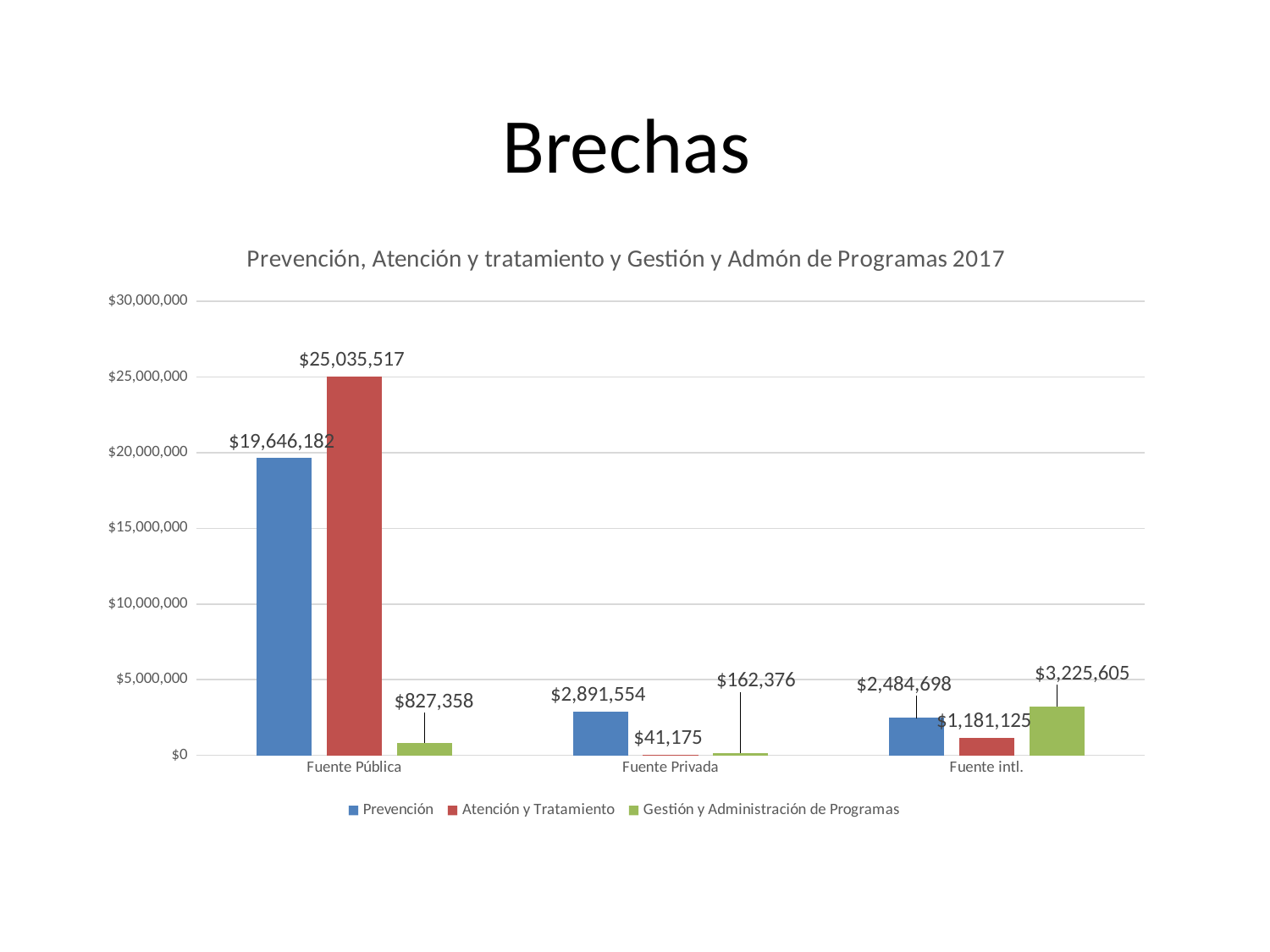
Which category has the highest value for Prevención? Fuente Pública What type of chart is shown on the slide? Bar chart What is the value for Atención y Tratamiento in Fuente Pública? $25,035,517 In Fuente intl., which is larger: Prevención or Gestión y Administración de Programas? Gestión y Administración de Programas What is the difference between Atención y Tratamiento and Prevención in Fuente Pública? $5,389,335 How many series does the legend list? 3 What is the value for Gestión y Administración de Programas in Fuente intl.? $3,225,605 What is the value for Prevención in Fuente Privada? $2,891,554 How many categories are shown on the x axis? 3 Which category has the lowest value for Atención y Tratamiento? Fuente Privada What is the title of the chart? Prevención, Atención y tratamiento y Gestión y Admón de Programas 2017 Is the value for Prevención in Fuente Pública greater or less than $15,000,000? greater